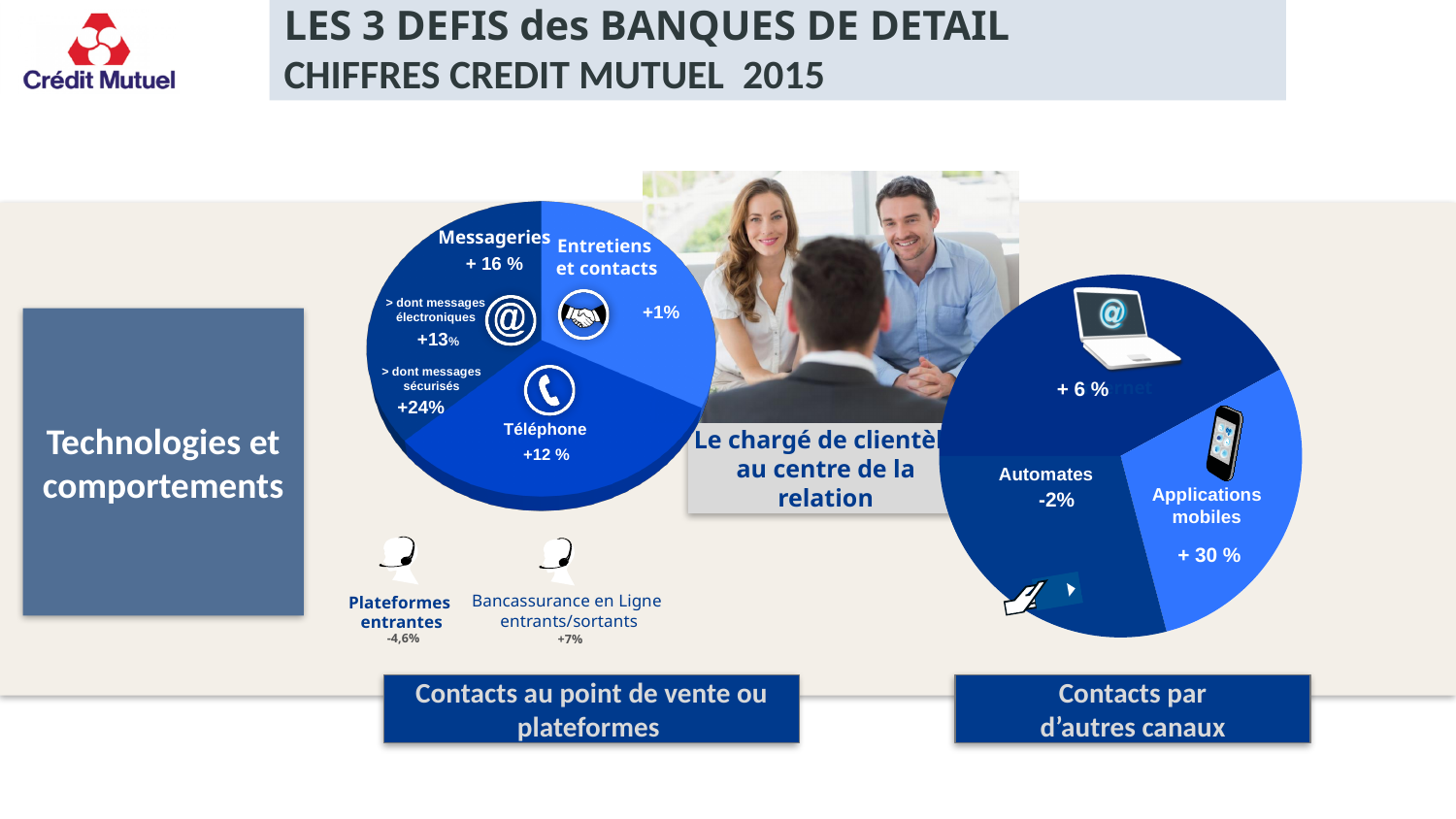
What kind of chart is used on the left side of the slide for Contacts au point de vente ou plateformes? Pie chart On the right pie chart (Contacts par d'autres canaux), what value is shown for Applications mobiles? + 30 % On the left pie chart, what value is shown for Entretiens et contacts? +1% How many slices does the right pie chart have? 3 On the left pie chart, what value is shown for Téléphone? +12 % On the right pie chart, which category has the highest value? Applications mobiles On the left pie chart (Contacts au point de vente ou plateformes), what value is shown for Messageries? + 16 % On the right pie chart, what value is shown for Automates? -2% On the left pie chart, which category has the lowest value? Entretiens et contacts On the right pie chart, which category has the lowest value? Automates On the left pie chart, which is larger: the value for Messageries or the value for Téléphone? Messageries What is the caption below the right pie chart? Contacts par d'autres canaux